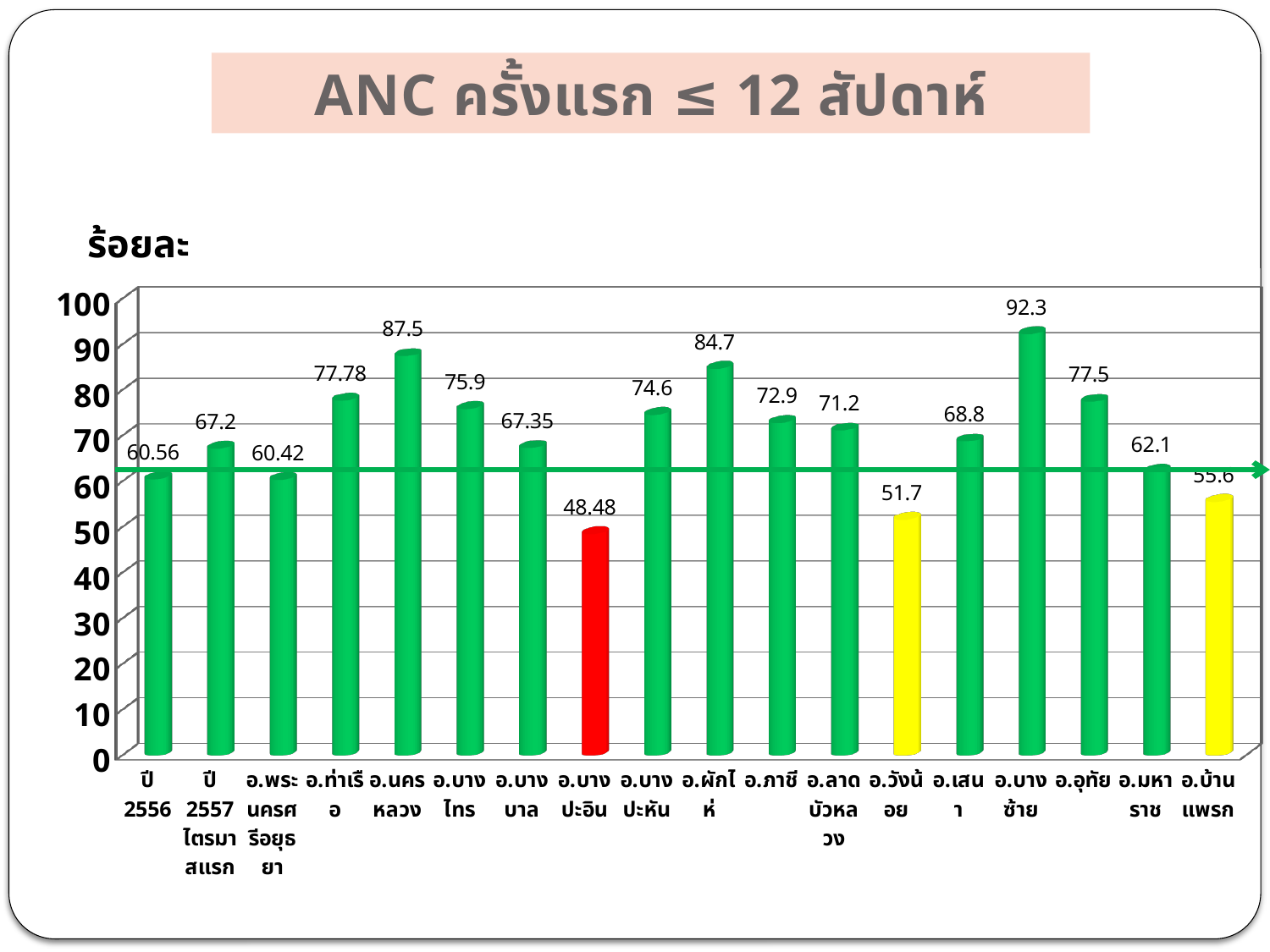
What is the difference between the values for อ.บางซ้าย and อ.บางปะอิน? 43.82 Which is larger, the value for อ.ผักไห่ or the value for อ.ท่าเรือ? อ.ผักไห่ What colour is the bar for อ.บางปะอิน? red What is the value for อ.นครหลวง? 87.5 Is the value for อ.วังน้อย greater or less than 60? less Which category has the highest value? อ.บางซ้าย What is the value for ปี 2557 ไตรมาสแรก? 67.2 What is the value for อ.บางปะอิน? 48.48 How many categories are shown on the x axis? 18 What is the title of the chart? ANC ครั้งแรก ≤ 12 สัปดาห์ What type of chart is shown on the slide? bar chart Which category has the lowest value? อ.บางปะอิน